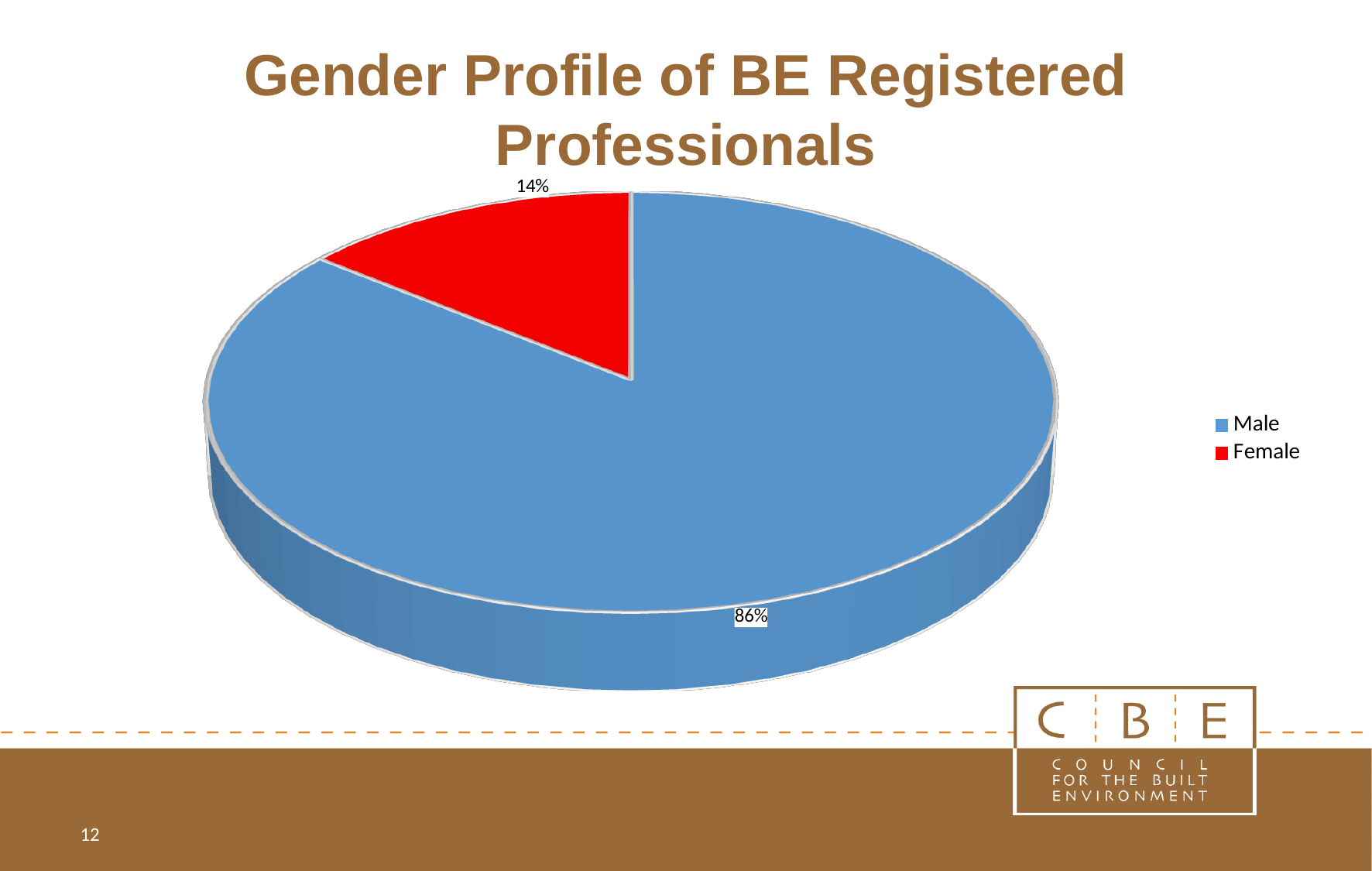
How many entries does the legend list? 2 Which gender has the smallest share of the pie? Female What share of BE registered professionals is Female? 14% How many slices does the pie chart have? 2 What is the title of the chart? Gender Profile of BE Registered Professionals Which is larger, the Male share or the Female share? Male What colour is the Female slice? Red What share of BE registered professionals is Male? 86% What kind of chart is shown on the slide? Pie chart Which gender has the largest share of the pie? Male What is the difference in percentage points between the Male and Female shares? 72